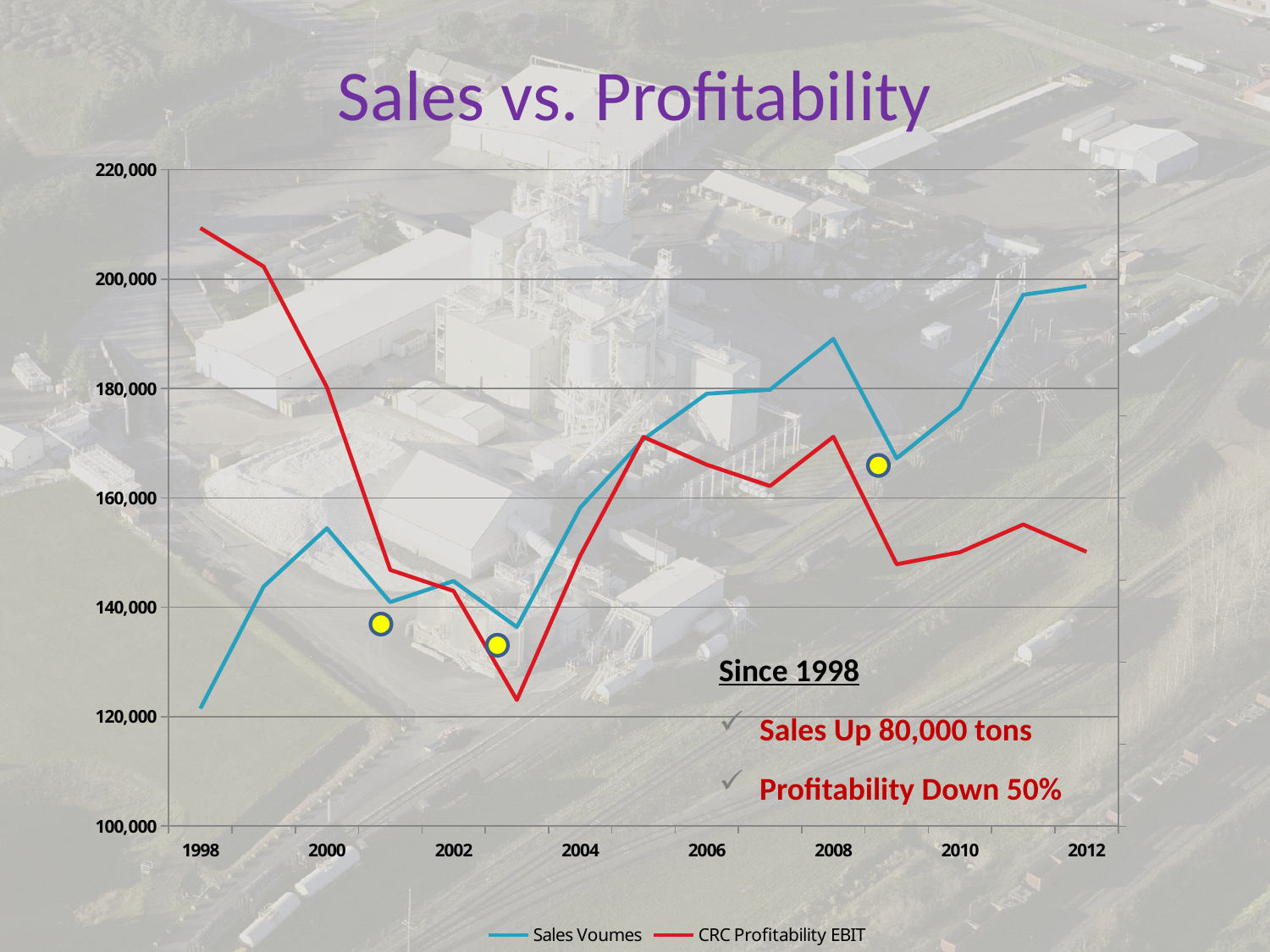
Is the CRC Profitability EBIT value for 1998 greater or less than 200,000? greater How many series does the chart's legend list? 2 Is the Sales Voumes value for 1998 greater or less than 140,000? less What are the two series named in the chart's legend? Sales Voumes and CRC Profitability EBIT In which year is the CRC Profitability EBIT line at its lowest? 2003 Overall, does the CRC Profitability EBIT line rise or fall from 1998 to 2012? fall What kind of chart is shown on the slide? line chart How many year labels are shown on the x axis of the chart? 8 In 1998, which series has the higher value, Sales Voumes or CRC Profitability EBIT? CRC Profitability EBIT Is the Sales Voumes value for 2012 greater or less than 180,000? greater What is the title of the chart on the slide? Sales vs. Profitability